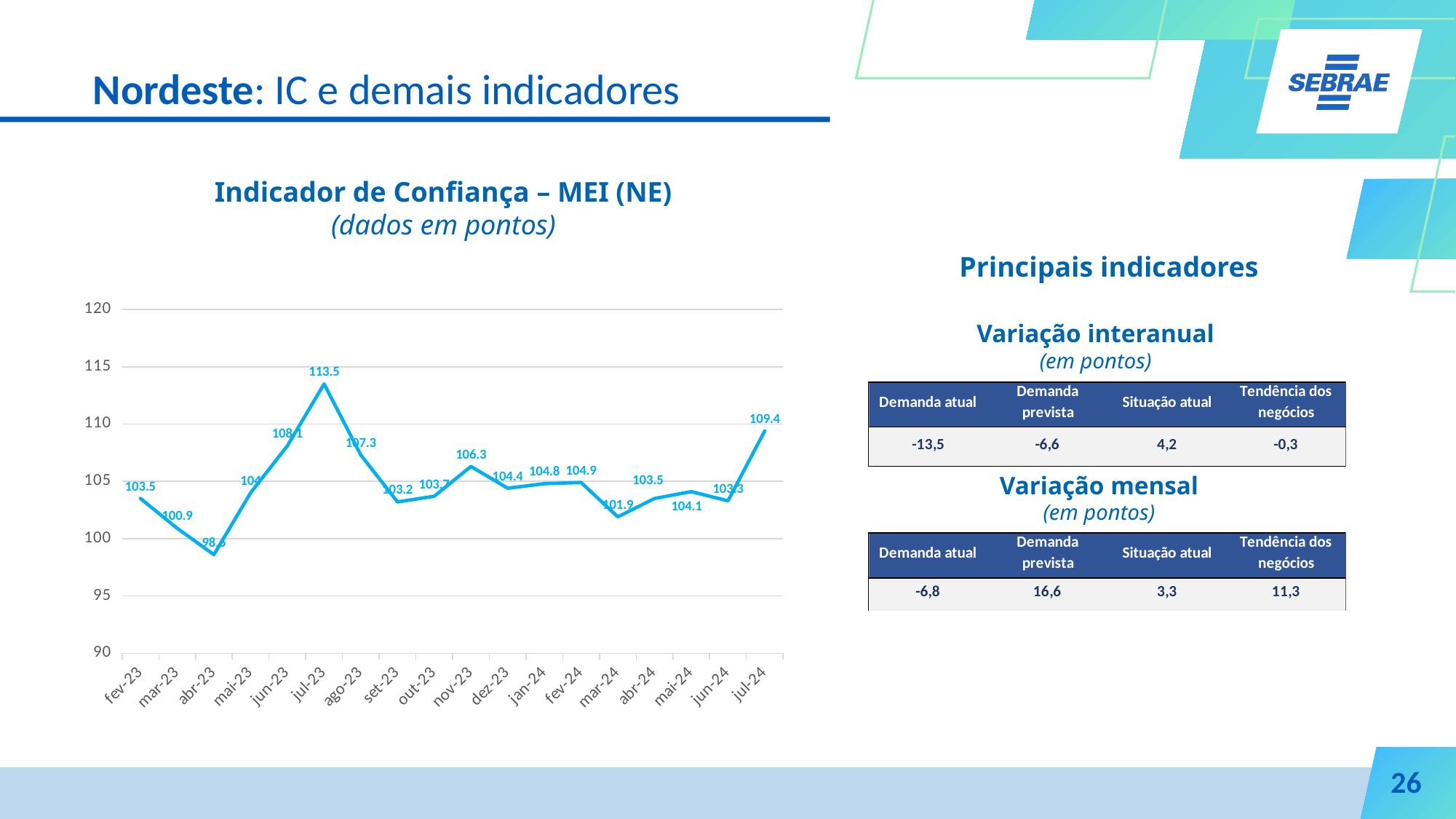
Does the value rise or fall from mar-24 to jul-24? rise How many months are plotted on the x axis of the chart? 18 Is the value for abr-23 greater or less than 100? less What type of chart is shown on the slide? line chart Which month has the highest value in the chart? jul-23 What is the value of the Indicador de Confiança for mar-24? 101.9 What is the value of the Indicador de Confiança for jul-24? 109.4 What is the value of the Indicador de Confiança for nov-23? 106.3 What is the difference between the values for jul-23 and jul-24? 4.1 Which is larger, the value for nov-23 or the value for dez-23? nov-23 Which month has the lowest value in the chart? abr-23 What is the value of the Indicador de Confiança for jul-23? 113.5